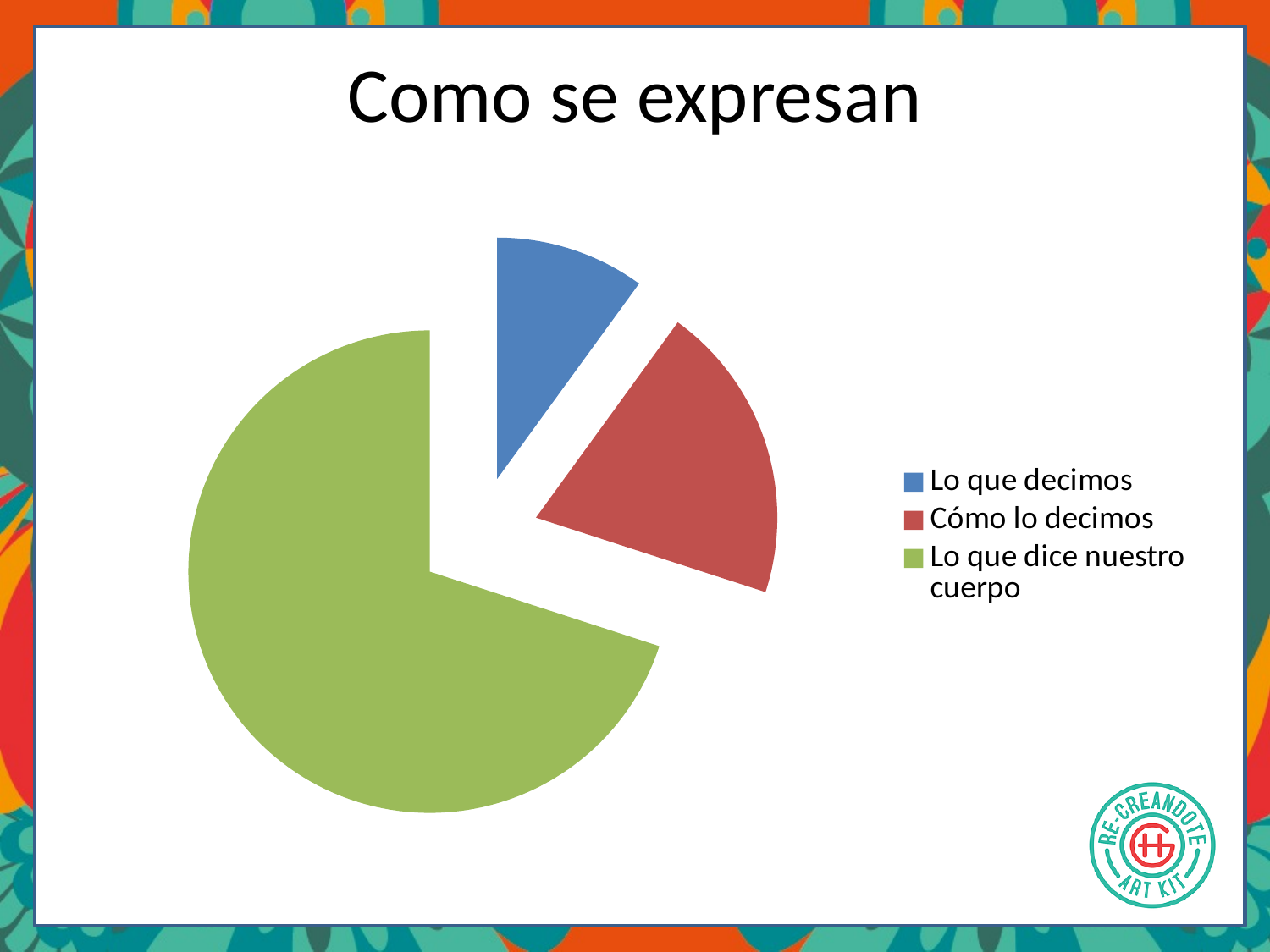
Which category has the largest slice of the pie chart? Lo que dice nuestro cuerpo Which category has the smallest slice of the pie chart? Lo que decimos How many entries does the legend of the pie chart list? 3 What kind of chart is shown on the slide? pie chart How many slices does the pie chart have? 3 What is the title of the chart on the slide? Como se expresan Which slice is larger, "Lo que decimos" or "Cómo lo decimos"? Cómo lo decimos Which slice is larger, "Cómo lo decimos" or "Lo que dice nuestro cuerpo"? Lo que dice nuestro cuerpo What colour is the slice for "Lo que dice nuestro cuerpo" in the pie chart? green